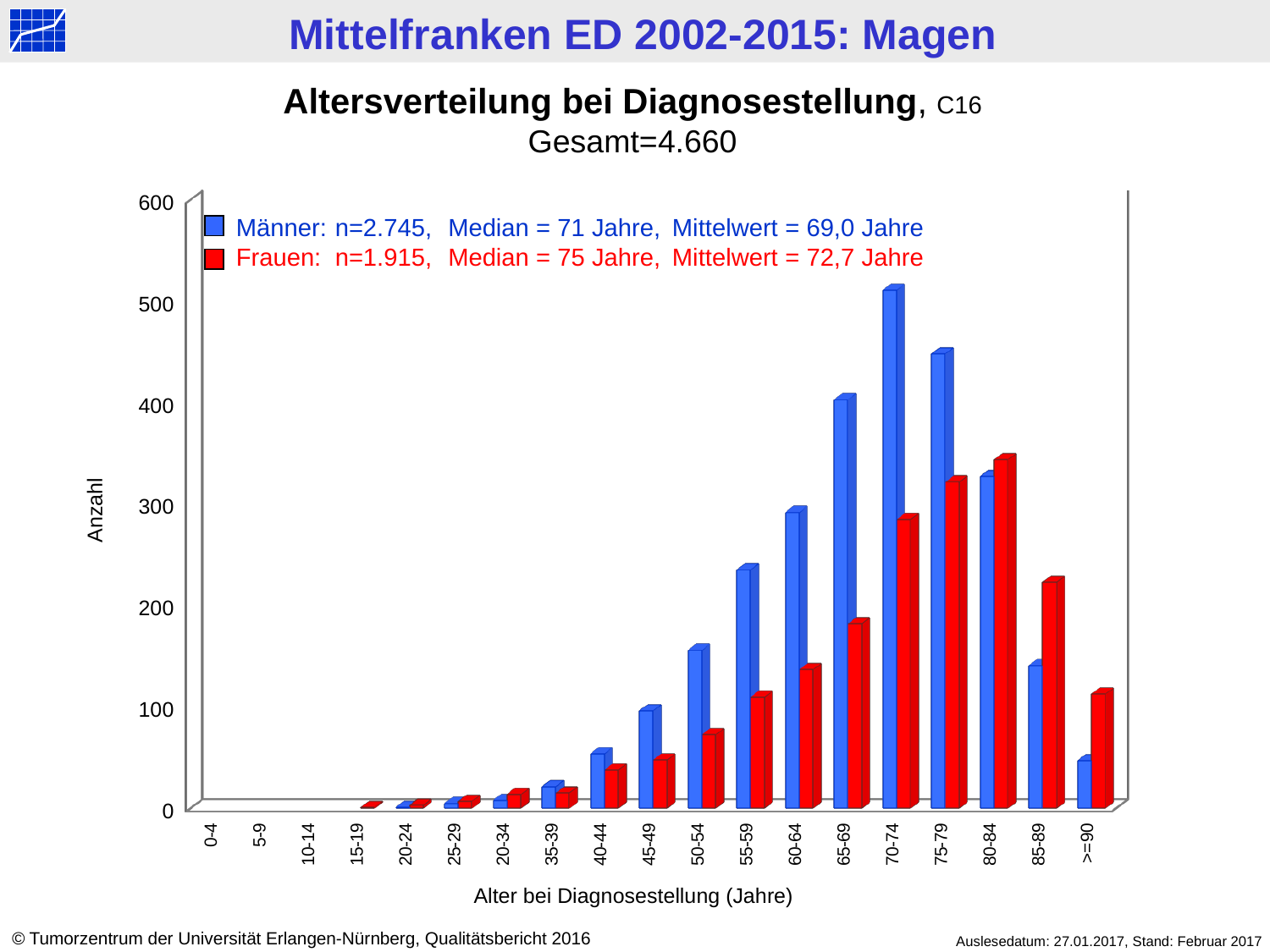
Is the value for Männer in the 55-59 category greater or less than 200? greater How many series does the legend list? 2 How many age categories are shown on the x axis? 19 In the 85-89 category, which series has the larger value, Männer or Frauen? Frauen What kind of chart is shown on the slide? bar chart Is the value for Frauen in the 85-89 category greater or less than 200? greater In which age category is the value for Männer highest? 70-74 Is the value for Frauen in the 60-64 category greater or less than 200? less In the 70-74 category, which series has the larger value, Männer or Frauen? Männer In which age category is the value for Frauen highest? 80-84 According to the legend, what is the median age for Frauen? 75 Jahre